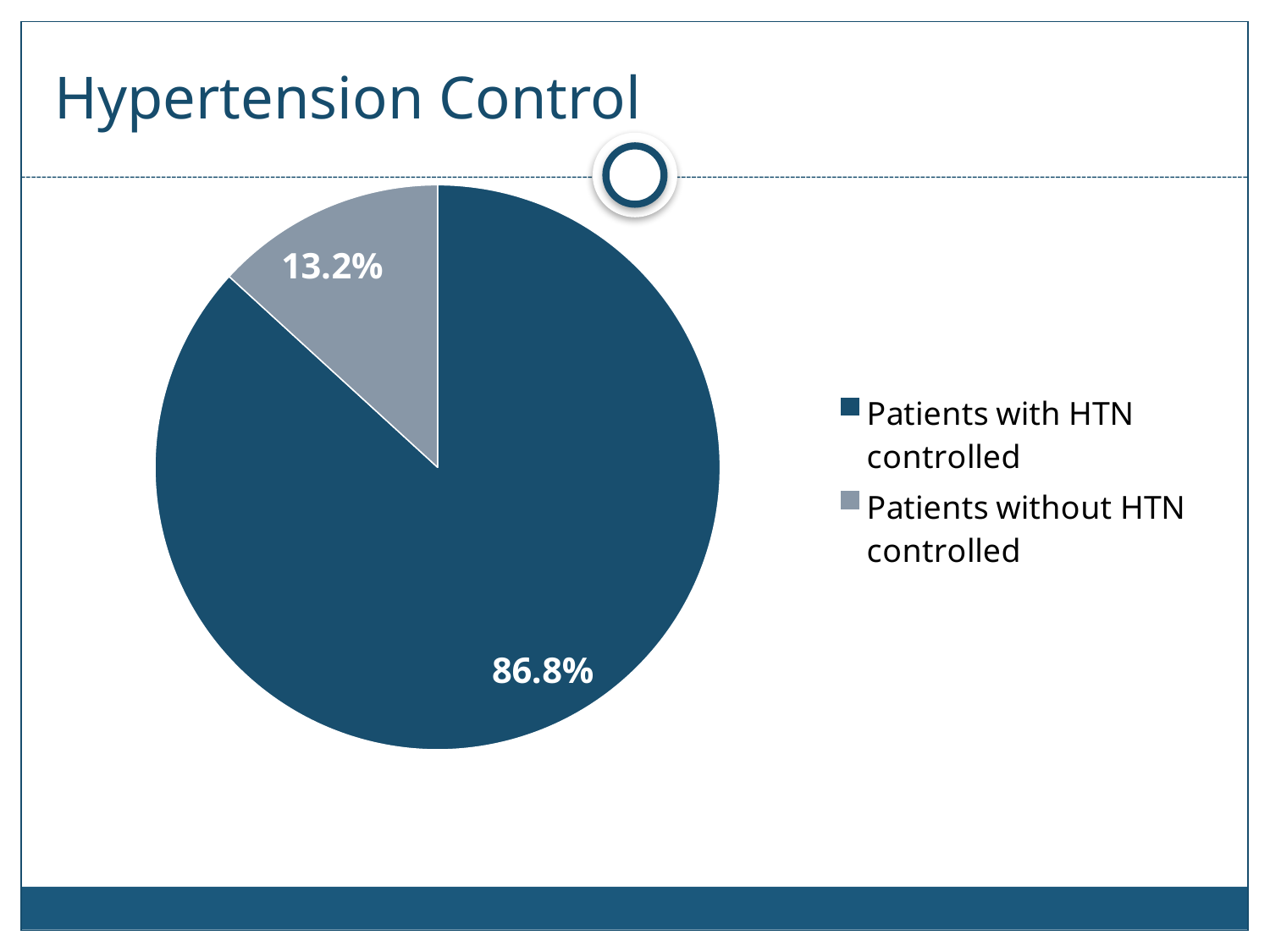
What share of the pie is taken by the slice labelled 86.8%? 86.8% What percentage of patients have HTN controlled? 86.8% What colour is the slice for patients without HTN controlled? Grey How many entries does the legend list? 2 Which category has the largest share of the pie? Patients with HTN controlled Which is larger: the share of patients with HTN controlled or the share of patients without HTN controlled? Patients with HTN controlled What is the difference in percentage points between patients with HTN controlled and patients without HTN controlled? 73.6 What is the title of the slide containing the chart? Hypertension Control What type of chart is shown on the slide? Pie chart What percentage of patients do not have HTN controlled? 13.2% Which category has the smallest share of the pie? Patients without HTN controlled How many slices does the pie chart have? 2